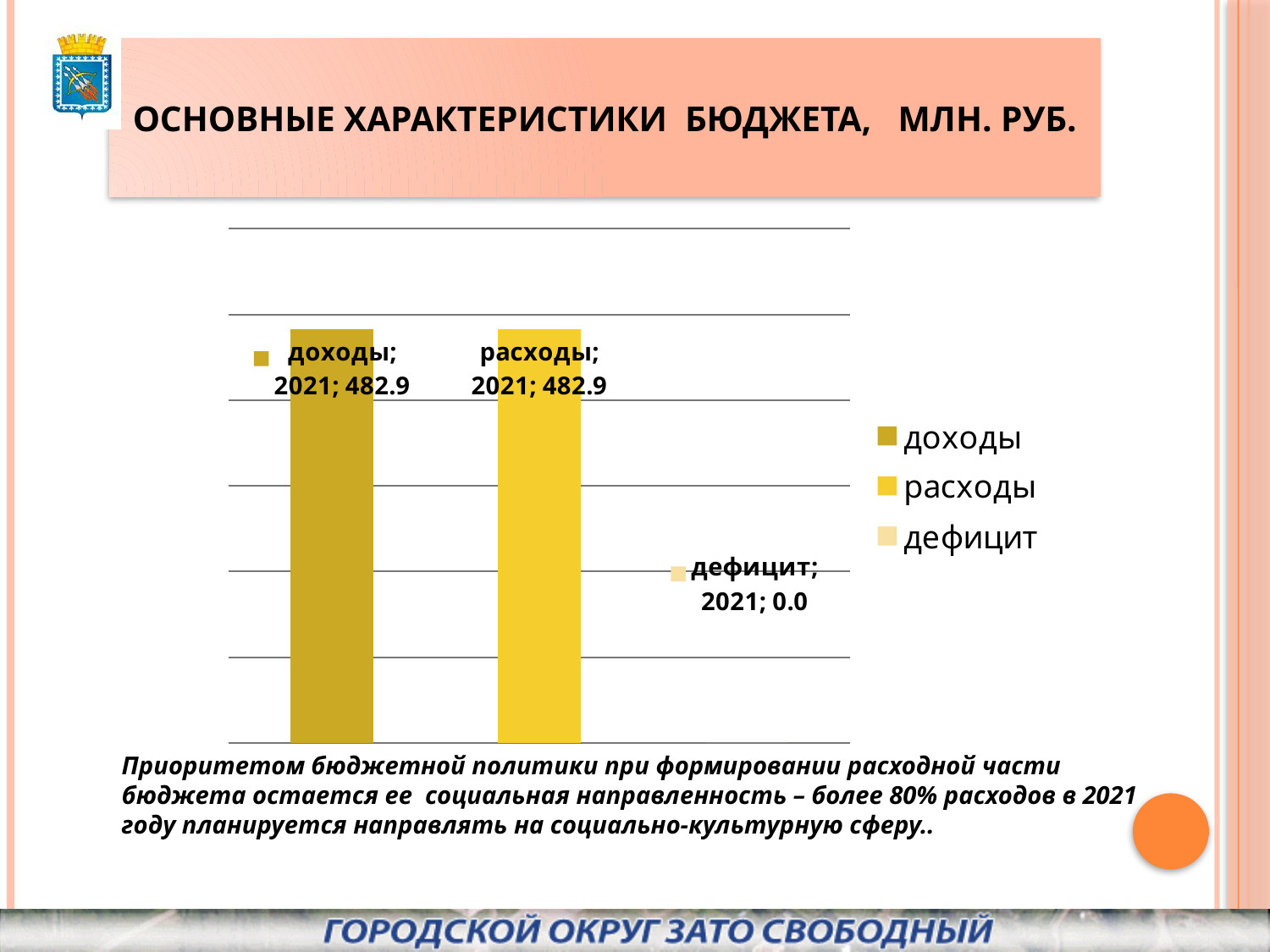
How many series does the legend list? 3 What is the value for доходы in 2021? 482.9 Which series has the lowest value on the chart? дефицит What is the value for дефицит in 2021? 0.0 What kind of chart is shown on the slide? bar chart What is the title of the slide above the chart? ОСНОВНЫЕ ХАРАКТЕРИСТИКИ БЮДЖЕТА, МЛН. РУБ. Which year do the data labels on the chart refer to? 2021 What is the difference between доходы and расходы in 2021? 0.0 What is the total of доходы and дефицит in 2021? 482.9 What is the difference between доходы and дефицит in 2021? 482.9 What is the value for расходы in 2021? 482.9 Which is larger, расходы or дефицит? расходы